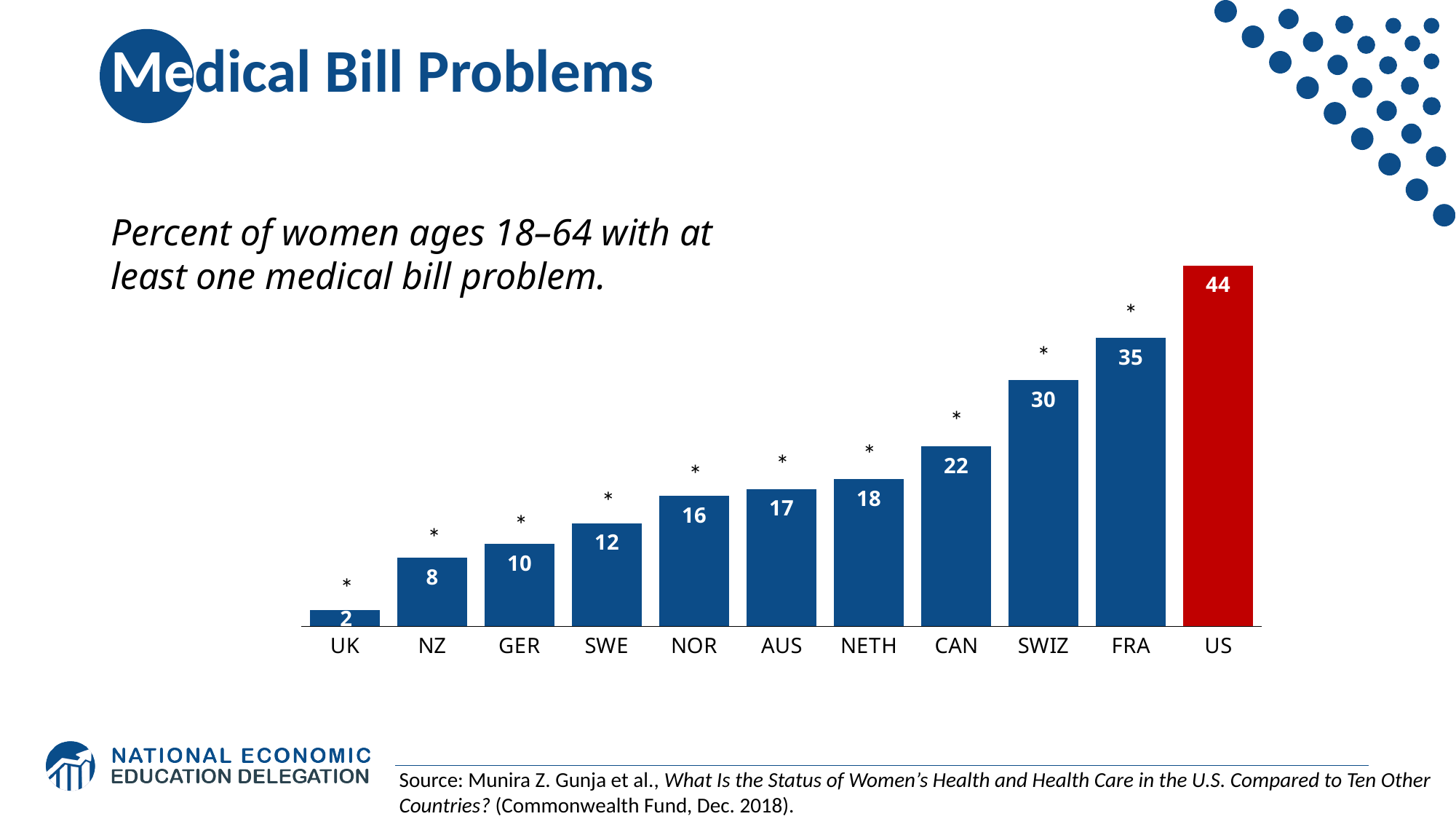
What is the value for CAN? 22 How many countries are shown on the chart? 11 Which bar is coloured red rather than blue? US Which country has the highest value? US What is the value for SWE? 12 What is the value for the US? 44 Which country has the lowest value? UK Which has a larger value, NOR or NETH? NETH Do the values rise or fall from left to right along the x axis? Rise What kind of chart is this? Bar chart What is the difference between the values for the US and FRA? 9 What is the difference between the values for SWIZ and NZ? 22